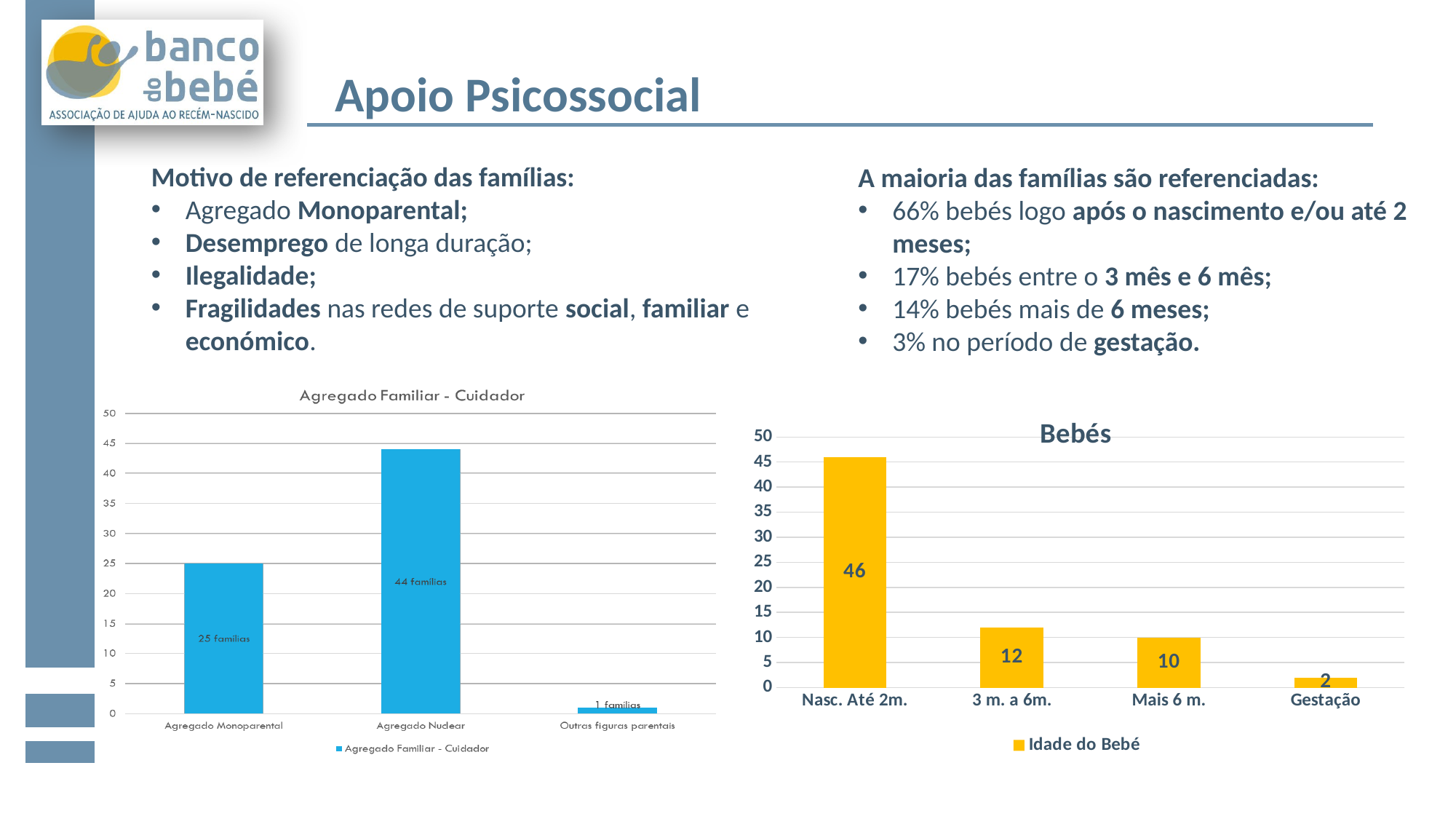
In the 'Agregado Familiar - Cuidador' chart, how many categories are shown on the x axis? 3 In the 'Agregado Familiar - Cuidador' chart, which category has the lowest value? Outras figuras parentais What kind of chart is the 'Bebés' chart? Bar chart In the 'Bebés' chart, what is the difference between Nasc. Até 2m. and Mais 6 m.? 36 In the 'Agregado Familiar - Cuidador' chart, what is the value for Agregado Nuclear? 44 famílias In the 'Bebés' chart, which is larger: 3 m. a 6m. or Mais 6 m.? 3 m. a 6m. In the 'Bebés' chart, which category has the highest value? Nasc. Até 2m. In the 'Agregado Familiar - Cuidador' chart, what is the value for Agregado Monoparental? 25 famílias In the 'Bebés' chart, what is the value for 3 m. a 6m.? 12 In the 'Bebés' chart, what is the value for Gestação? 2 In the 'Bebés' chart, what series name does the legend show? Idade do Bebé In the 'Agregado Familiar - Cuidador' chart, what is the difference between Agregado Nuclear and Agregado Monoparental? 19 famílias